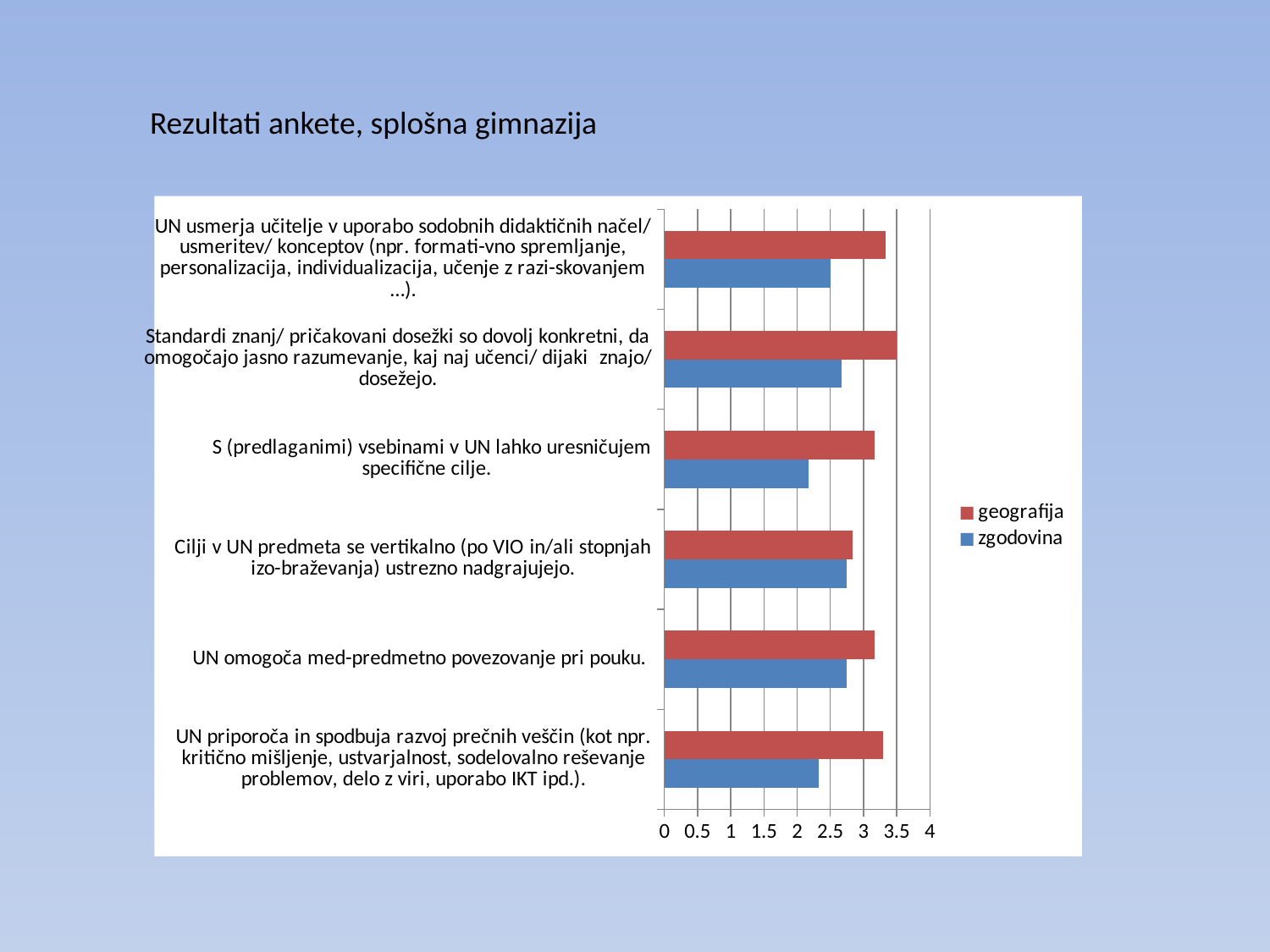
Is the geografija value for 'UN omogoča med-predmetno povezovanje pri pouku.' greater or less than 3? greater Which series is shown in red? geografija How many categories are shown on the chart? 6 What kind of chart is shown on the slide? bar chart Is the zgodovina value for 'S (predlaganimi) vsebinami v UN lahko uresničujem specifične cilje.' greater or less than 2.5? less Is the zgodovina value for 'UN priporoča in spodbuja razvoj prečnih veščin...' greater or less than 2.5? less How many series does the legend list? 2 Which category has the highest geografija value? Standardi znanj/ pričakovani dosežki so dovolj konkretni, da omogočajo jasno razumevanje, kaj naj učenci/ dijaki znajo/ dosežejo. For 'S (predlaganimi) vsebinami v UN lahko uresničujem specifične cilje.', which series has the larger value, geografija or zgodovina? geografija What is the title of the slide? Rezultati ankete, splošna gimnazija